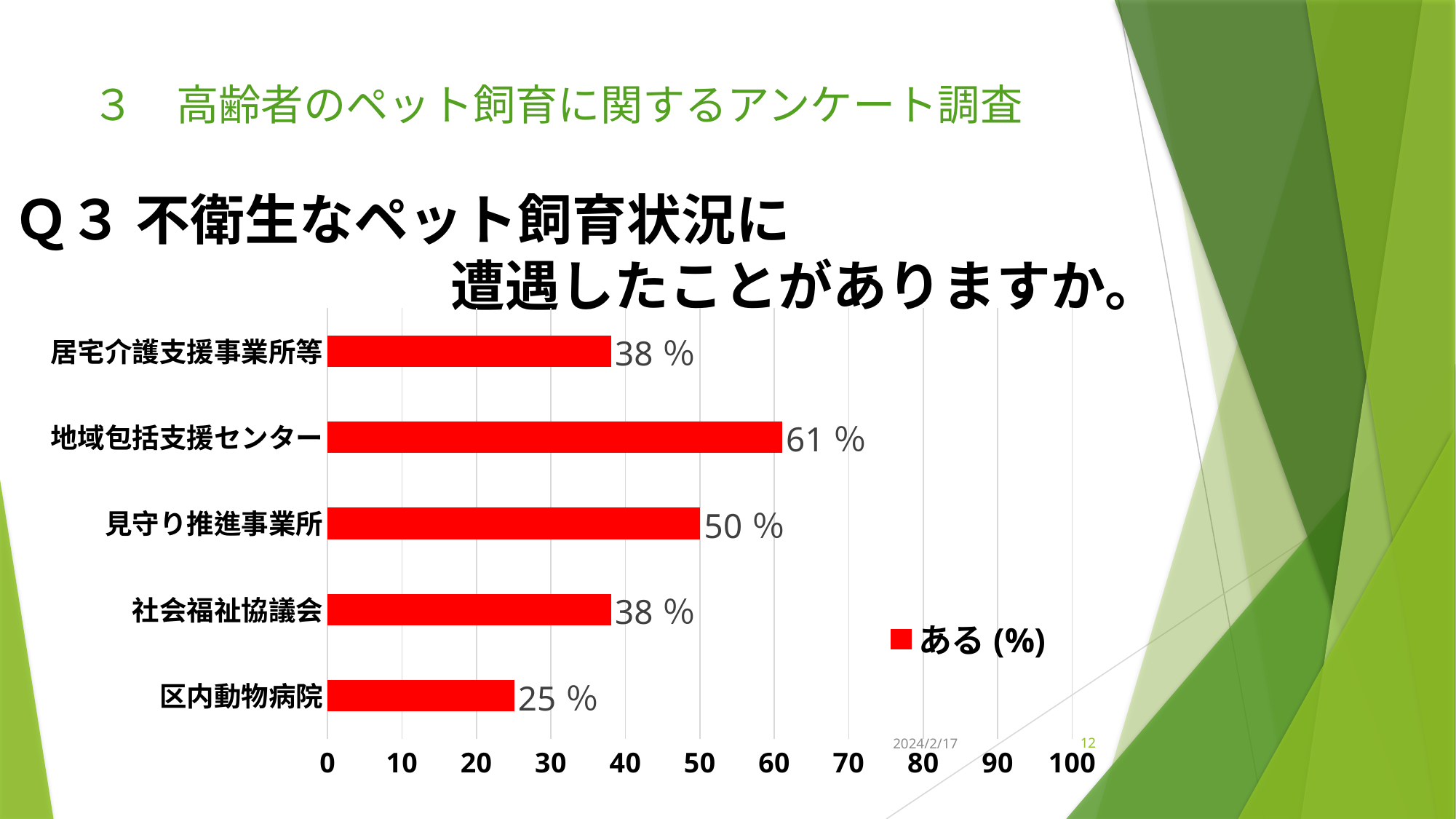
What is the value for 地域包括支援センター? 61 % What series name does the legend show? ある (%) What kind of chart is shown on the slide? bar chart What is the value for 区内動物病院? 25 % What is the value for 見守り推進事業所? 50 % What is the difference between the values for 地域包括支援センター and 区内動物病院? 36 % Which category has the highest value? 地域包括支援センター What is the value for 社会福祉協議会? 38 % Which category has the lowest value? 区内動物病院 Is the value for 地域包括支援センター greater or less than 50? greater How many categories are shown in the chart? 5 Which is larger, the value for 見守り推進事業所 or the value for 居宅介護支援事業所等? 見守り推進事業所